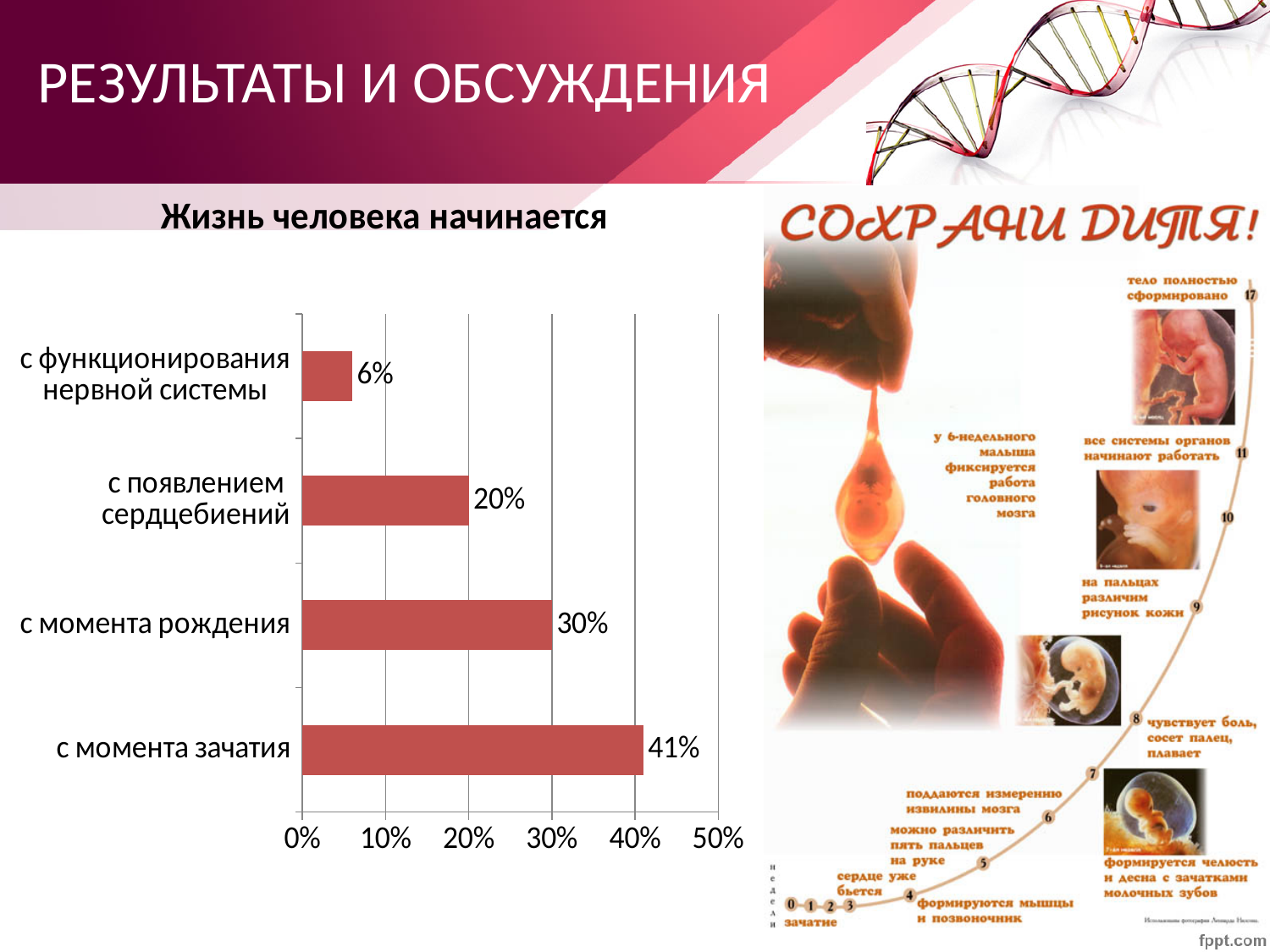
What is the value for "с момента зачатия"? 41% Is the value for "с момента зачатия" greater or less than 40%? greater Which category has the highest value? с момента зачатия Which category has the lowest value? с функционирования нервной системы What kind of chart is shown on the slide? bar chart What is the value for "с момента рождения"? 30% What is the difference between the values for "с момента зачатия" and "с момента рождения"? 11% Which is larger: the value for "с появлением сердцебиений" or "с момента рождения"? с момента рождения What is the value for "с функционирования нервной системы"? 6% How many categories are shown in the chart? 4 What is the title of the chart? Жизнь человека начинается What is the value for "с появлением сердцебиений"? 20%